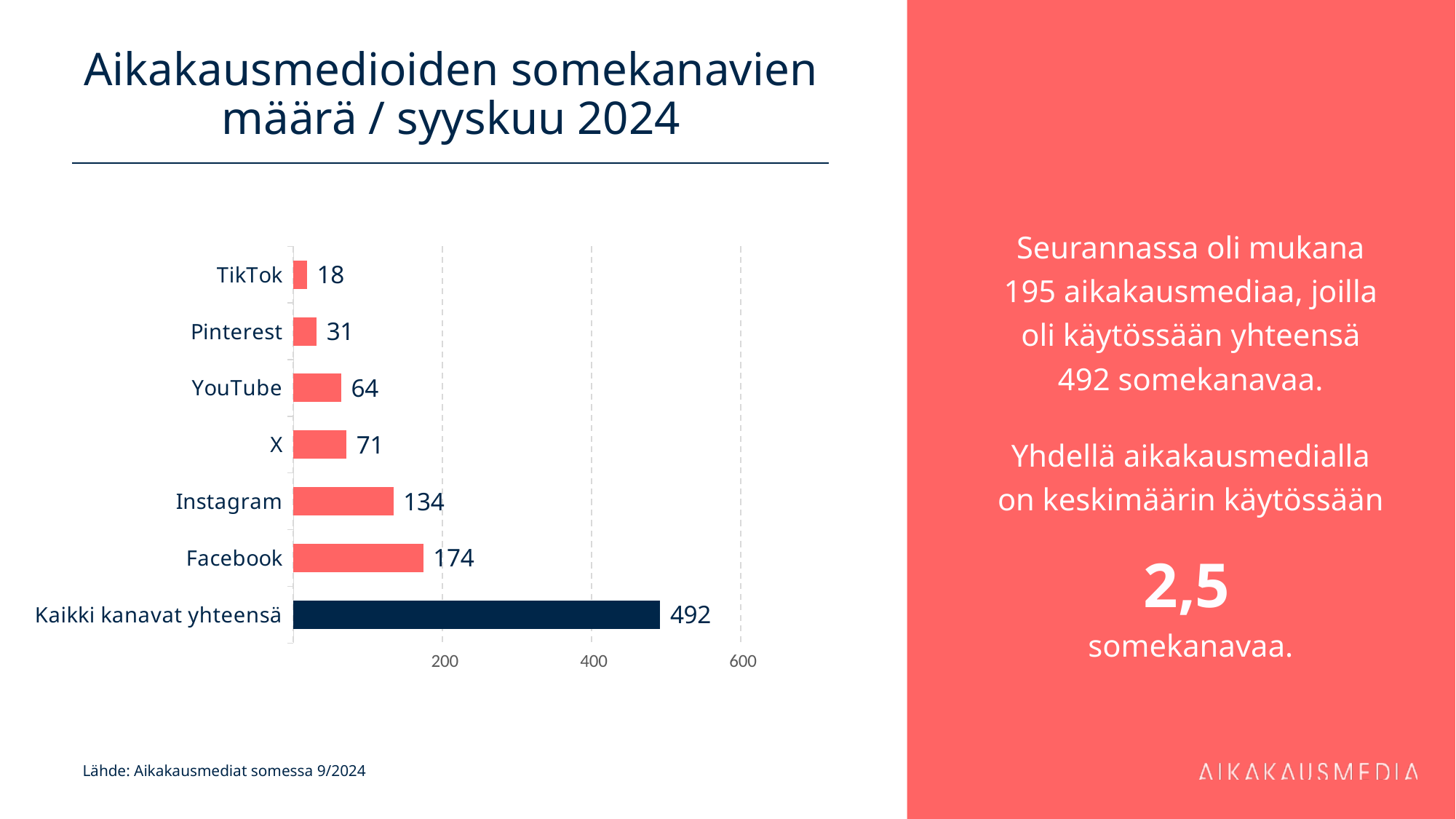
Which is larger, the value for X or the value for YouTube? X What kind of chart is shown on the slide? bar chart What is the value for TikTok? 18 Which individual channel (excluding the total bar) has the highest value? Facebook Which category has the lowest value? TikTok What is the value for Facebook? 174 How many categories are shown in the chart? 7 What is the value for Kaikki kanavat yhteensä? 492 What is the value for Instagram? 134 What is the title of the chart on the slide? Aikakausmedioiden somekanavien määrä / syyskuu 2024 What is the difference between the values for Facebook and Instagram? 40 Is the value for Instagram greater or less than 200? less